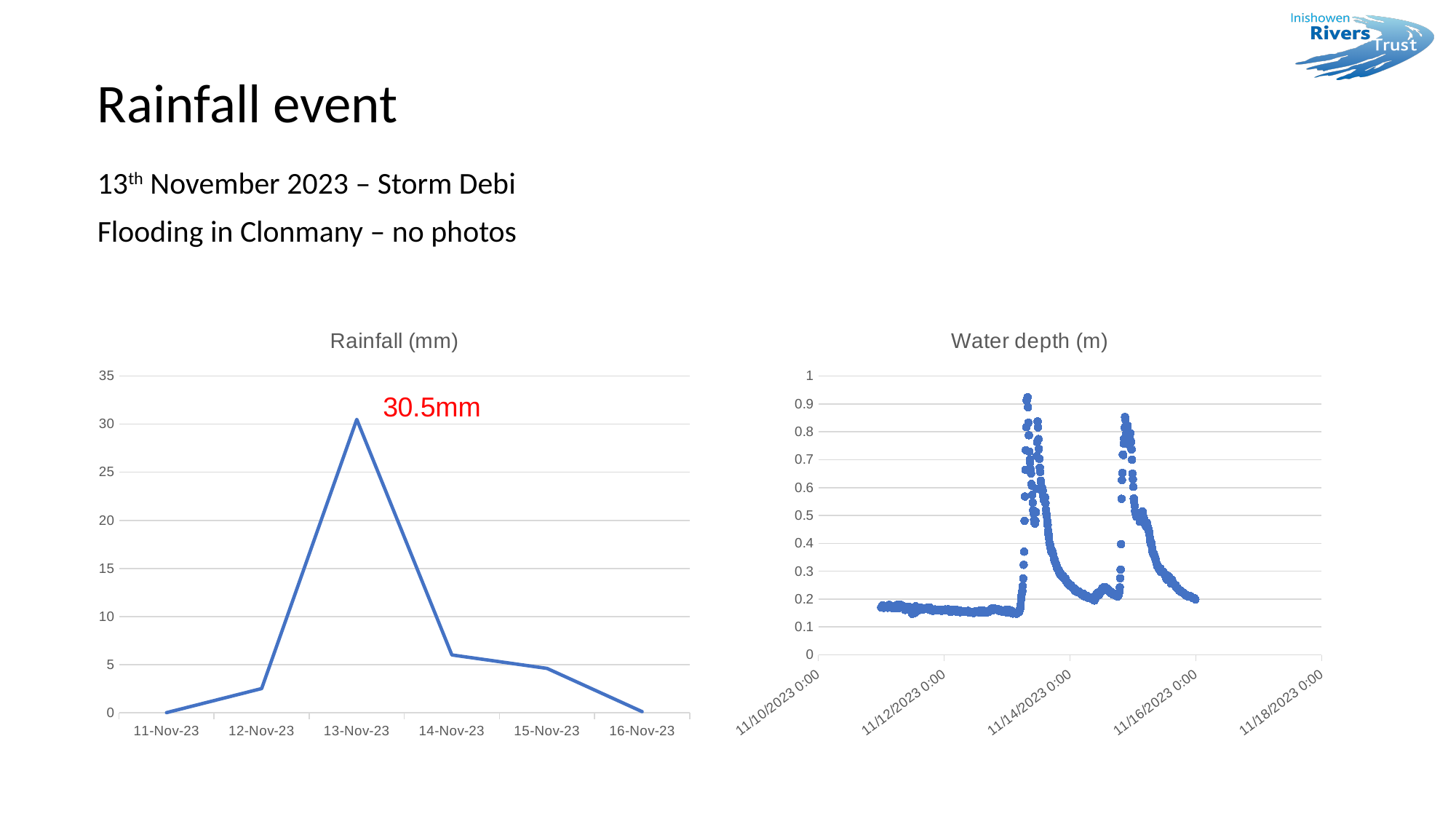
On the Rainfall (mm) chart, is the value for 14-Nov-23 greater or less than 10? less What kind of chart is the Rainfall (mm) chart? line chart What kind of chart is the Water depth (m) chart? scatter chart What is the title of the chart on the right side of the slide? Water depth (m) On the Rainfall (mm) chart, what is the rainfall value on 13-Nov-23? 30.5mm On the Rainfall (mm) chart, which date has the highest rainfall? 13-Nov-23 On the Rainfall (mm) chart, is the value for 12-Nov-23 greater or less than 5? less On the Rainfall (mm) chart, how many dates are shown on the x axis? 6 On the Water depth (m) chart, what is the maximum value shown on the y axis? 1 On the Water depth (m) chart, is the highest water depth greater or less than 0.8? greater On the Rainfall (mm) chart, do the values rise or fall from 13-Nov-23 to 16-Nov-23? fall On the Rainfall (mm) chart, which has the higher rainfall, 12-Nov-23 or 14-Nov-23? 14-Nov-23